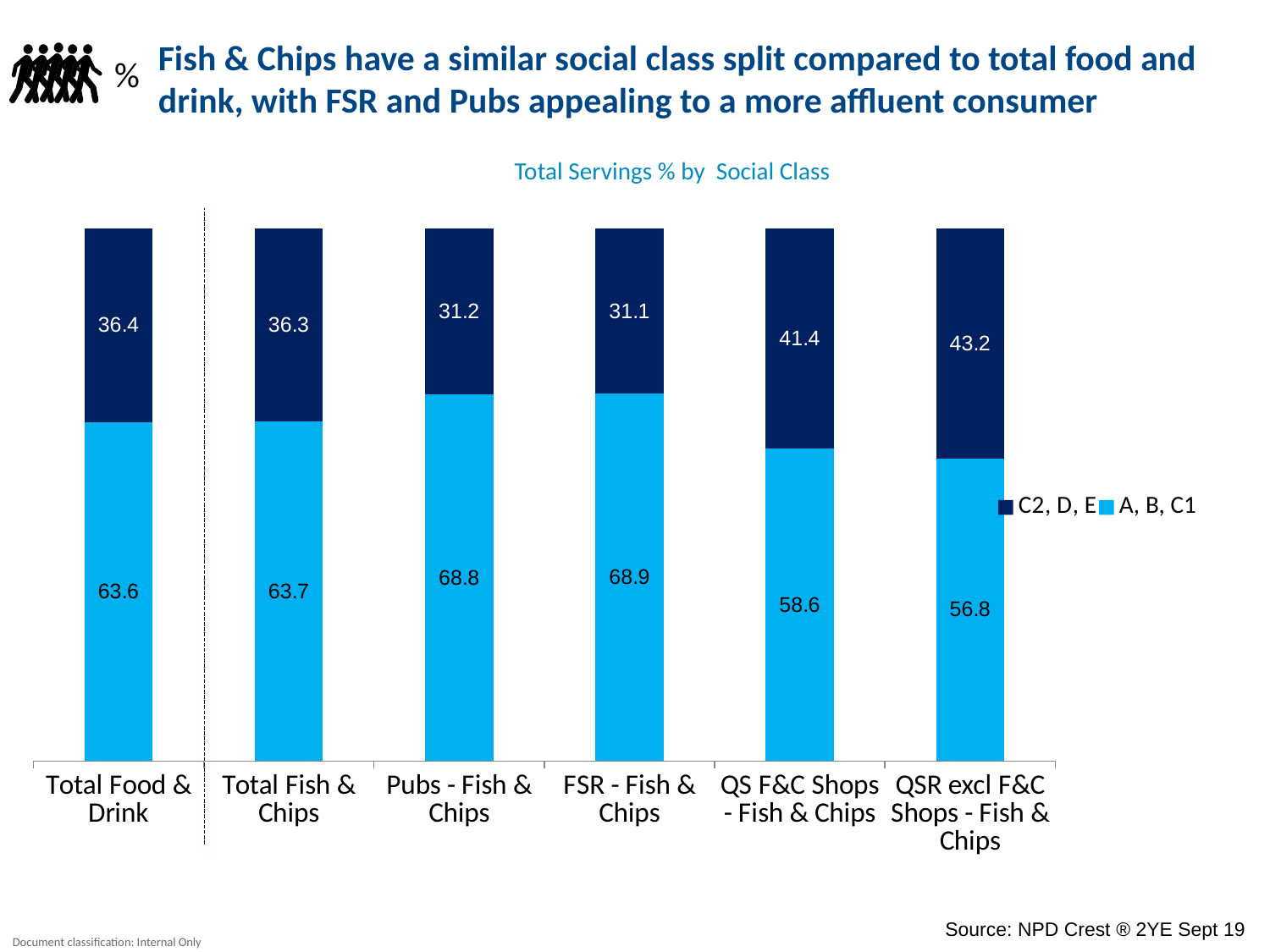
What is the difference between the A, B, C1 values for Pubs - Fish & Chips and QS F&C Shops - Fish & Chips? 10.2 Which category has the lowest A, B, C1 value? QSR excl F&C Shops - Fish & Chips What is the title of the chart? Total Servings % by Social Class How many series does the legend list? 2 How many categories are shown on the x axis? 6 What is the A, B, C1 value for FSR - Fish & Chips? 68.9 What is the C2, D, E value for Pubs - Fish & Chips? 31.2 What is the C2, D, E value for QSR excl F&C Shops - Fish & Chips? 43.2 What kind of chart is shown? Stacked bar chart Which category has the highest C2, D, E value? QSR excl F&C Shops - Fish & Chips Which is larger: the C2, D, E value for QS F&C Shops - Fish & Chips or for Total Fish & Chips? QS F&C Shops - Fish & Chips What is the A, B, C1 value for Total Food & Drink? 63.6